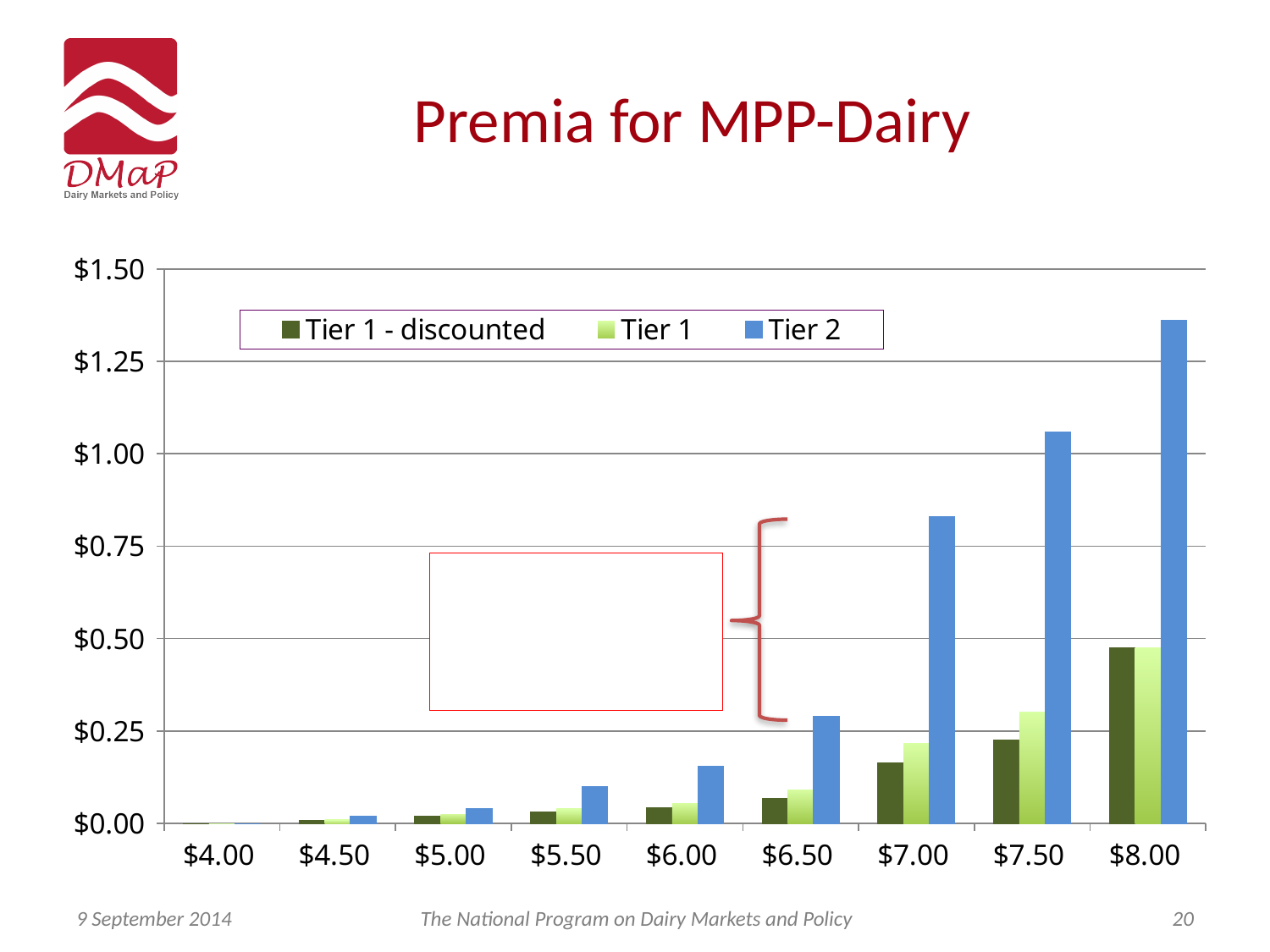
What is the title of the chart? Premia for MPP-Dairy How many categories are shown on the x axis? 9 Is the Tier 2 value at $6.00 greater or less than $0.25? less What type of chart is shown on the slide? bar chart Is the Tier 1 value at $7.00 greater or less than $0.25? less At which x-axis category is the Tier 2 bar highest? $8.00 Do the Tier 2 values rise or fall as the x-axis values increase from $4.00 to $8.00? rise Which series is shown in blue in the legend? Tier 2 Is the Tier 2 value at $7.00 greater or less than $0.75? greater At $7.00, which is larger: the Tier 2 value or the Tier 1 value? Tier 2 How many series does the legend list? 3